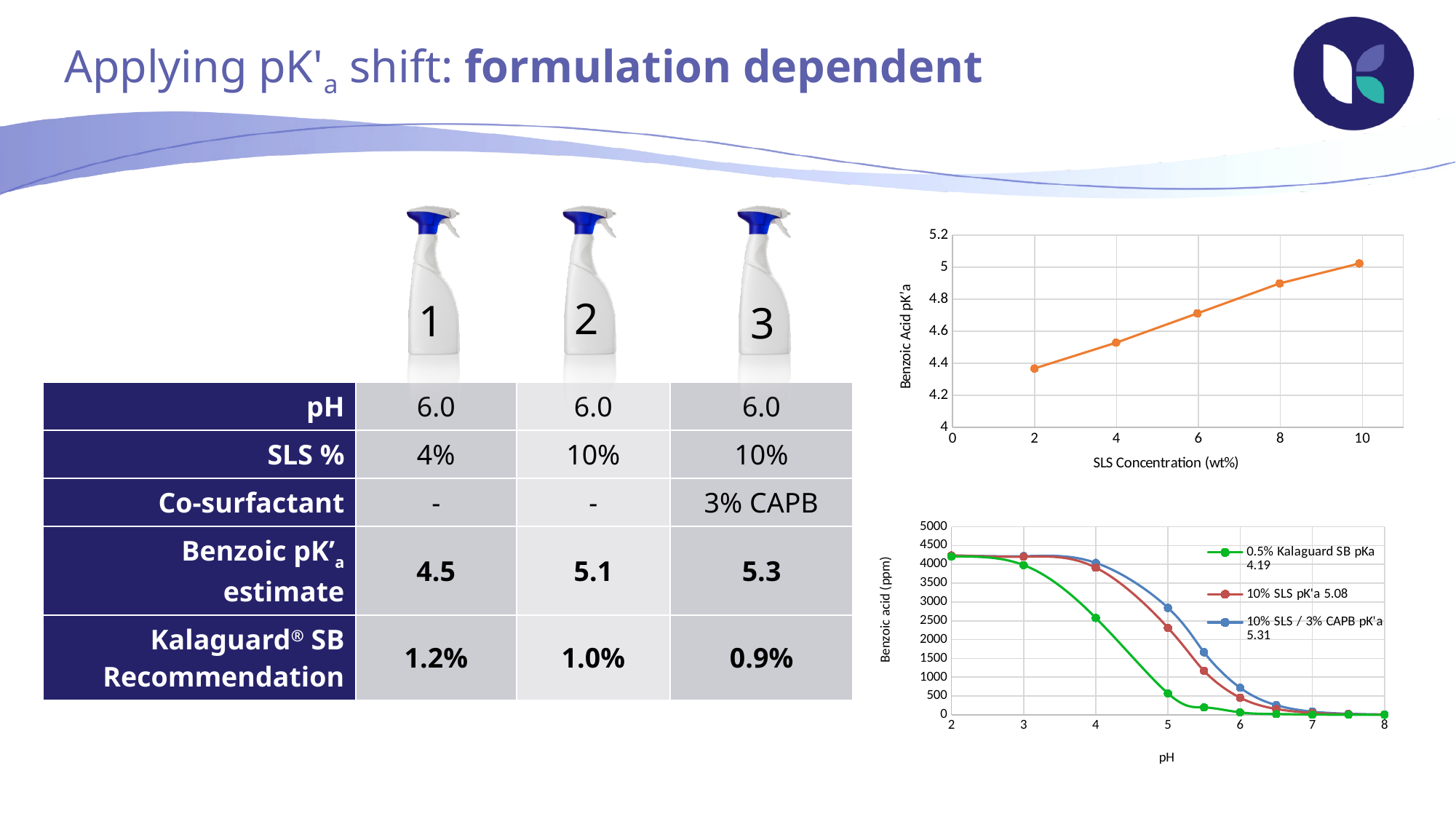
What is the x-axis title of the top-right chart? SLS Concentration (wt%) In the top-right chart, is the Benzoic Acid pK'a at 8 wt% SLS greater or less than 4.8? greater In the bottom-right chart, which series has the highest Benzoic acid (ppm) at pH 5? 10% SLS / 3% CAPB pK'a 5.31 In the top-right chart, does Benzoic Acid pK'a rise or fall as SLS Concentration increases? rise In the bottom-right chart of Benzoic acid (ppm) versus pH, how many series does the legend list? 3 In the bottom-right chart, is the Benzoic acid (ppm) for the 0.5% Kalaguard SB pKa 4.19 series at pH 5 greater or less than 1000? less In the bottom-right chart, does Benzoic acid (ppm) rise or fall as pH increases? fall In the top-right chart, is the Benzoic Acid pK'a at 2 wt% SLS greater or less than 4.6? less In the top-right chart, how many data points are plotted? 5 In the bottom-right chart, which series is shown in green? 0.5% Kalaguard SB pKa 4.19 What type of chart is the top-right chart of Benzoic Acid pK'a versus SLS Concentration? line chart